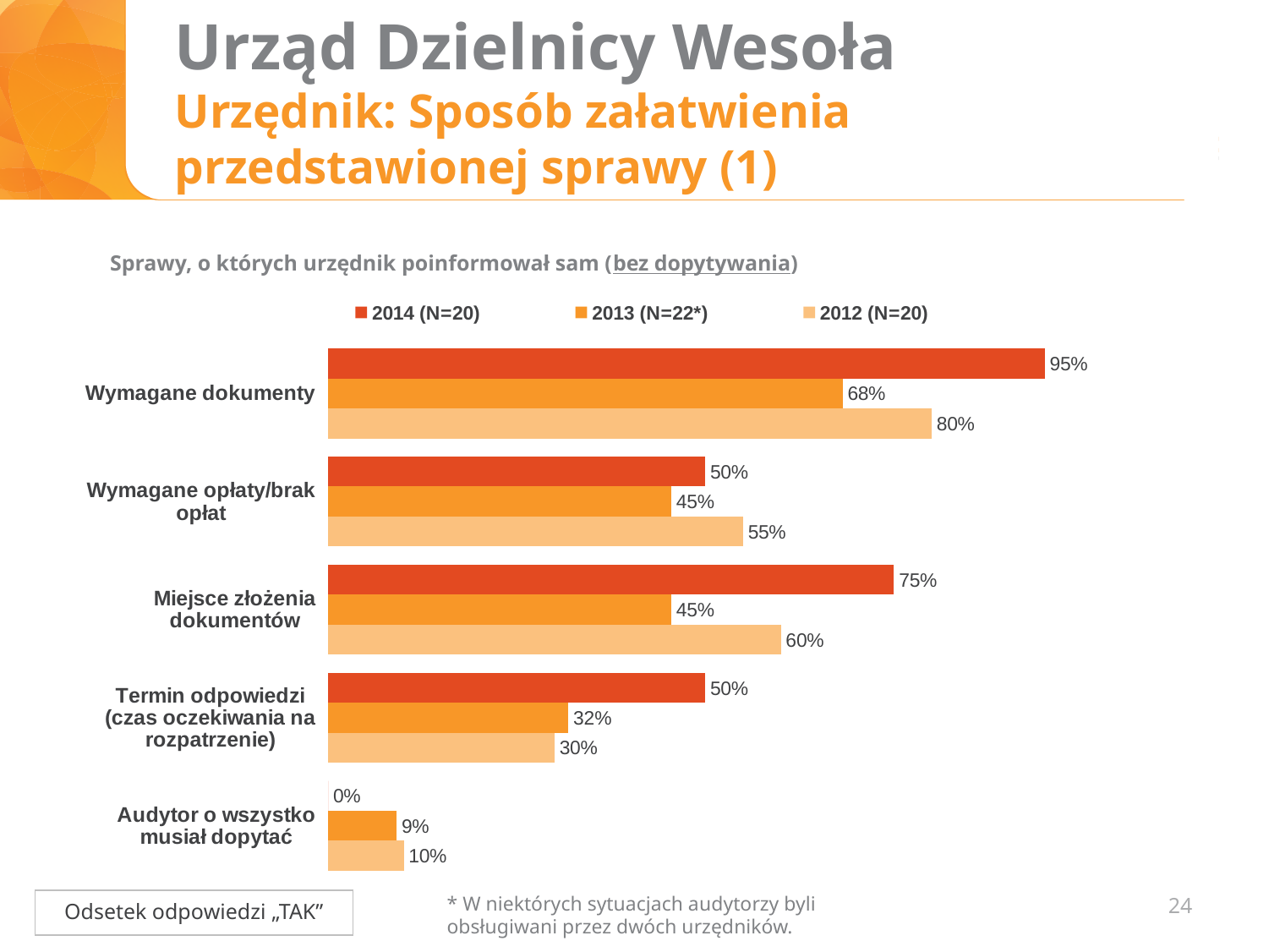
How many series does the legend list? 3 What kind of chart is shown on the slide? Bar chart What is the sample size given in the legend for the 2013 series? N=22* For "Wymagane opłaty/brak opłat", which series has the larger value: 2014 (N=20) or 2012 (N=20)? 2012 (N=20) What is the value for "Miejsce złożenia dokumentów" in the 2012 (N=20) series? 60% Which category has the highest value in the 2014 (N=20) series? Wymagane dokumenty What is the value for "Audytor o wszystko musiał dopytać" in the 2014 (N=20) series? 0% What is the value for "Wymagane dokumenty" in the 2014 (N=20) series? 95% Which category has the lowest value in the 2013 (N=22*) series? Audytor o wszystko musiał dopytać How many categories are shown on the chart? 5 What is the difference between the 2014 and 2013 values for "Miejsce złożenia dokumentów"? 30 percentage points What is the value for "Termin odpowiedzi (czas oczekiwania na rozpatrzenie)" in the 2013 (N=22*) series? 32%